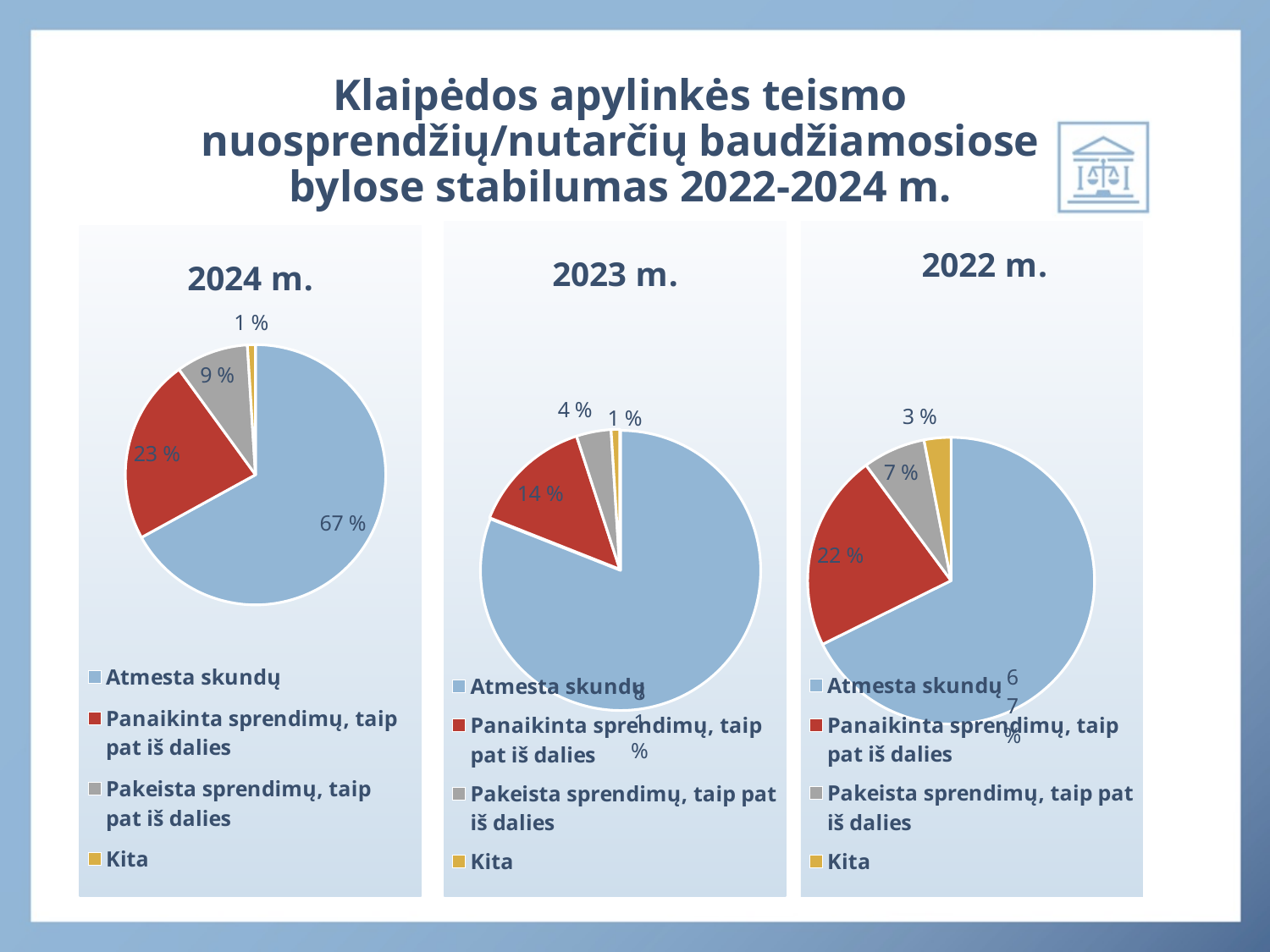
How many categories does the legend of the 2023 m. pie chart list? 4 In the 2024 m. pie chart, what share is shown for Atmesta skundų? 67 % In the 2024 m. pie chart, what share is shown for Pakeista sprendimų, taip pat iš dalies? 9 % In the 2023 m. pie chart, what share is shown for Panaikinta sprendimų, taip pat iš dalies? 14 % In the 2024 m. pie chart, which category has the largest slice? Atmesta skundų In the 2023 m. pie chart, what share is shown for Kita? 1 % In the 2024 m. pie chart, what share is shown for Panaikinta sprendimų, taip pat iš dalies? 23 % In the 2024 m. pie chart, what is the difference between the shares for Panaikinta sprendimų, taip pat iš dalies and Pakeista sprendimų, taip pat iš dalies? 14 % In the 2022 m. pie chart, what share is shown for Panaikinta sprendimų, taip pat iš dalies? 22 % Which is larger: the Panaikinta sprendimų, taip pat iš dalies share in the 2024 m. chart or in the 2023 m. chart? 2024 m. In the 2022 m. pie chart, what share is shown for Kita? 3 % In the 2022 m. pie chart, which category has the smallest slice? Kita